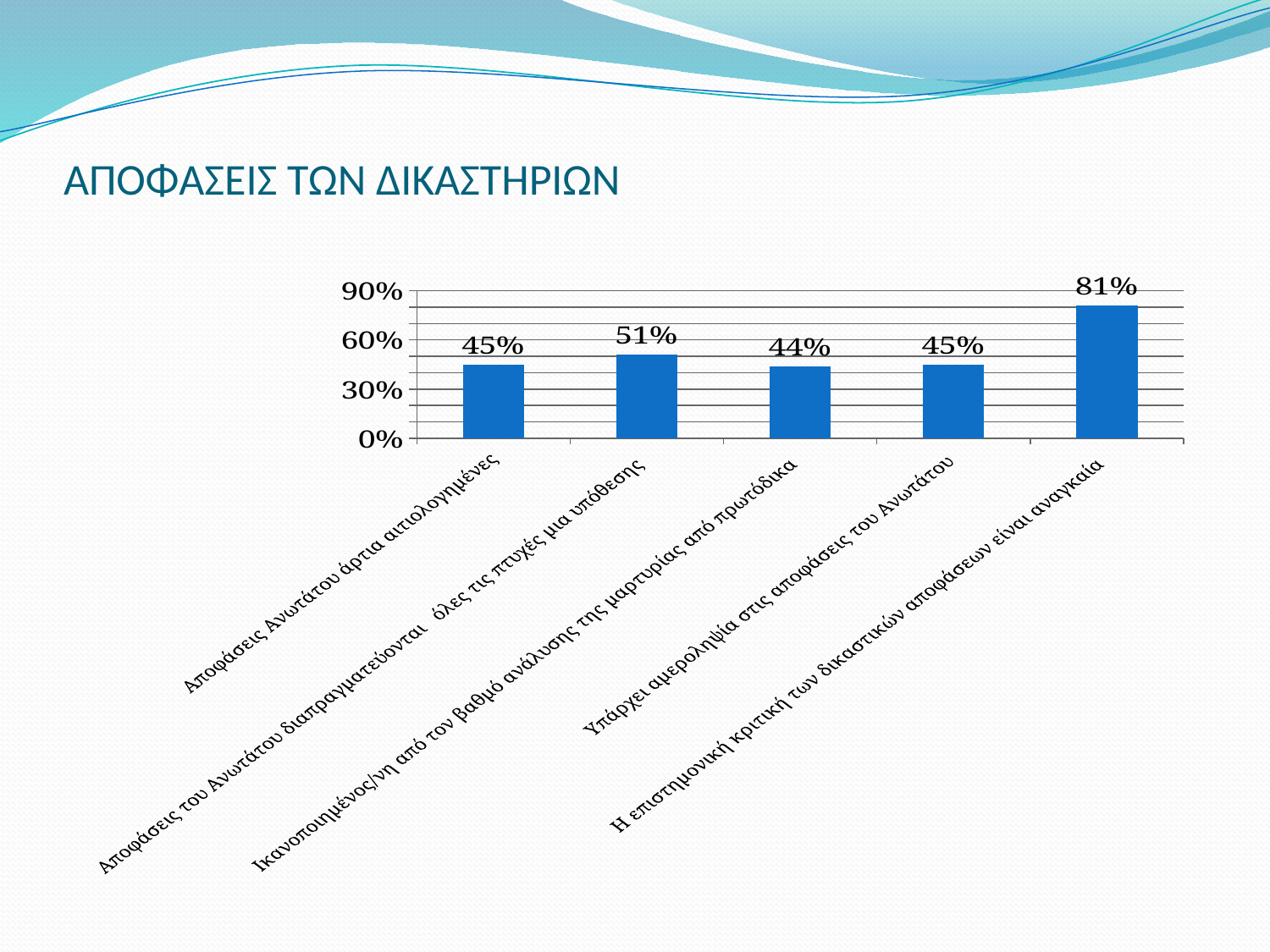
What is the value for "Αποφάσεις του Ανωτάτου διαπραγματεύονται όλες τις πτυχές μια υπόθεσης"? 51% What is the value for "Υπάρχει αμεροληψία στις αποφάσεις του Ανωτάτου"? 45% What is the title of the slide containing the chart? ΑΠΟΦΑΣΕΙΣ ΤΩΝ ΔΙΚΑΣΤΗΡΙΩΝ What type of chart is shown on the slide? bar chart What is the value for "Αποφάσεις Ανωτάτου άρτια αιτιολογημένες"? 45% What is the value for "Η επιστημονική κριτική των δικαστικών αποφάσεων είναι αναγκαία"? 81% Which category has the lowest value? Ικανοποιημένος/νη από τον βαθμό ανάλυσης της μαρτυρίας από πρωτόδικα How many categories (bars) does the chart show? 5 What is the difference between the value for "Η επιστημονική κριτική των δικαστικών αποφάσεων είναι αναγκαία" and the value for "Αποφάσεις του Ανωτάτου διαπραγματεύονται όλες τις πτυχές μια υπόθεσης"? 30% Which category has the highest value? Η επιστημονική κριτική των δικαστικών αποφάσεων είναι αναγκαία Which is larger: the value for "Αποφάσεις του Ανωτάτου διαπραγματεύονται όλες τις πτυχές μια υπόθεσης" or the value for "Υπάρχει αμεροληψία στις αποφάσεις του Ανωτάτου"? Αποφάσεις του Ανωτάτου διαπραγματεύονται όλες τις πτυχές μια υπόθεσης What is the value for "Ικανοποιημένος/νη από τον βαθμό ανάλυσης της μαρτυρίας από πρωτόδικα"? 44%